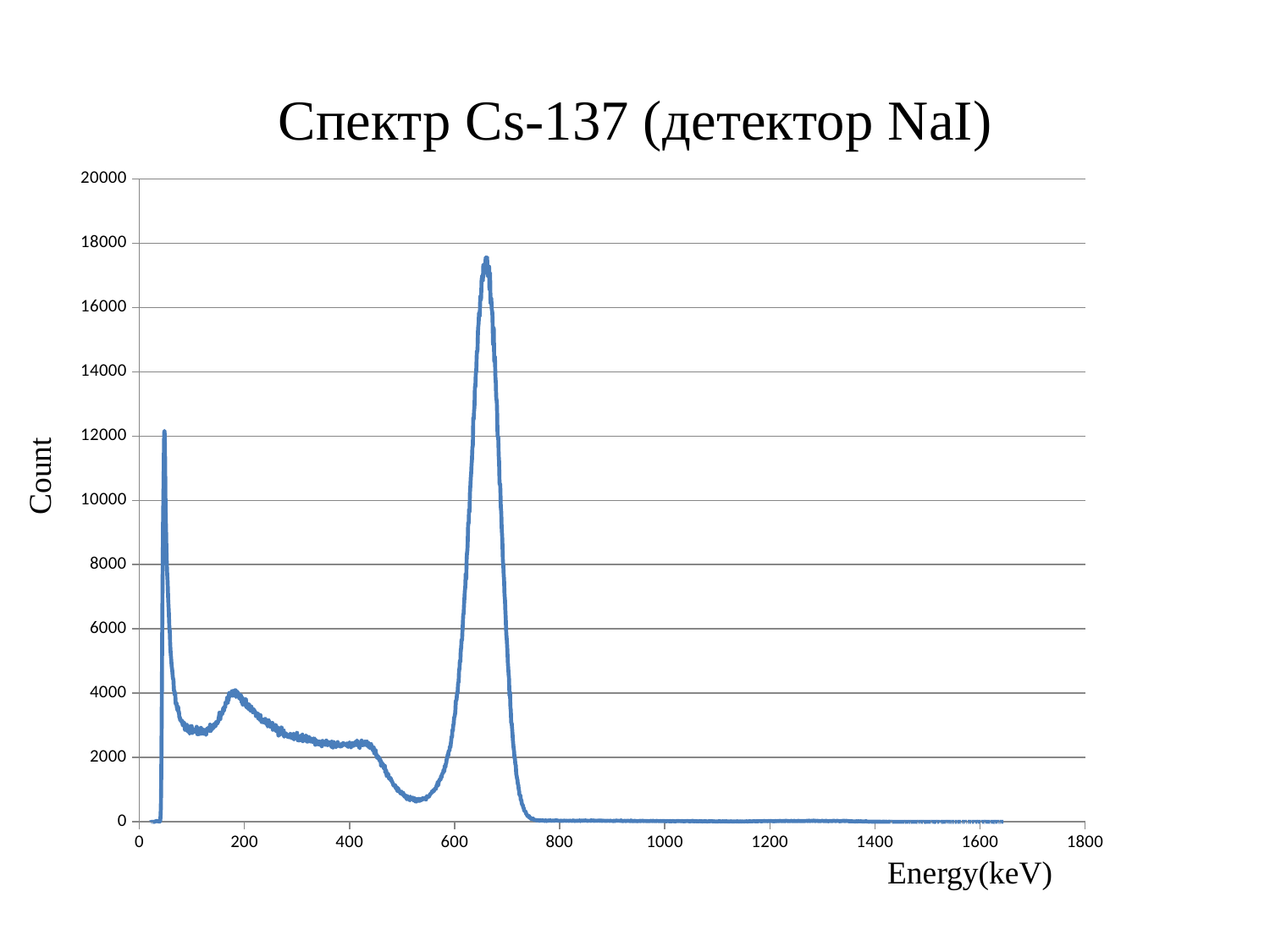
Does the count rise or fall as energy increases from 200 keV to 400 keV? fall Is the count at 400 keV greater or less than 4000? less Is the count at the sharp peak near 50 keV greater or less than 10000? greater What kind of chart is shown on the slide? line chart What is the title of the chart? Спектр Cs-137 (детектор NaI) Is the count at 200 keV greater or less than 2000? greater Does the count rise or fall as energy increases from 550 keV to 650 keV? rise Which peak is higher: the one near 50 keV or the one near 660 keV? the one near 660 keV What is the label of the horizontal axis? Energy(keV)